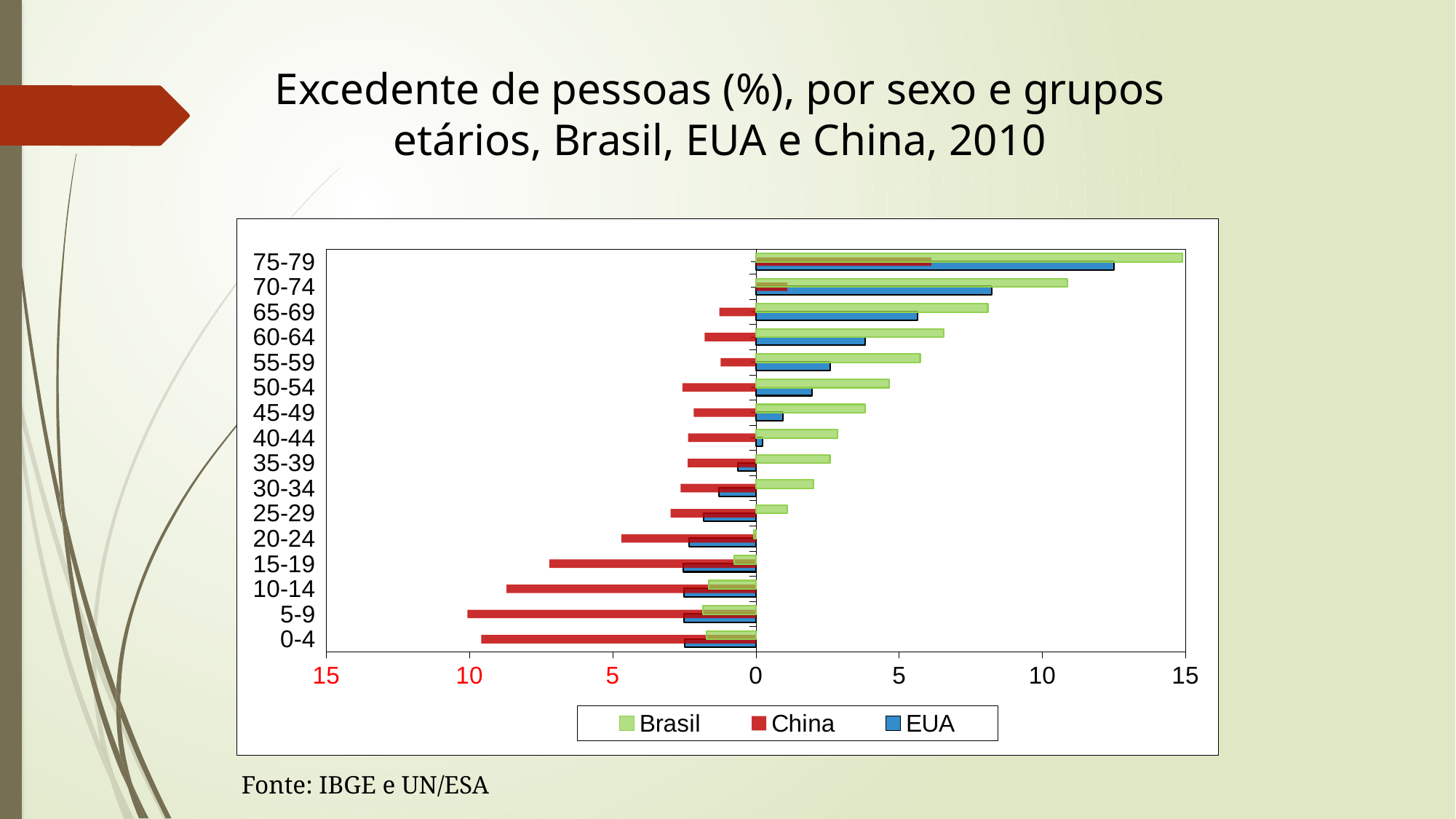
Is the value for EUA in the 60-64 age group greater or less than 5? less In the 50-54 age group, which is larger, the value for Brasil or the value for EUA? Brasil Is the value for Brasil in the 75-79 age group greater or less than 10? greater How many series does the legend list? 3 How many age groups are shown on the vertical axis? 16 Which age group has the highest value for Brasil? 75-79 Which age group has the longest China bar on the left (negative) side of the axis? 5-9 Which age group has the highest value for EUA? 75-79 Is the value for Brasil in the 65-69 age group greater or less than 10? less Do the Brasil values rise or fall as the age groups get older? rise Which series is shown in red in the legend? China What kind of chart is shown on the slide? Bar chart